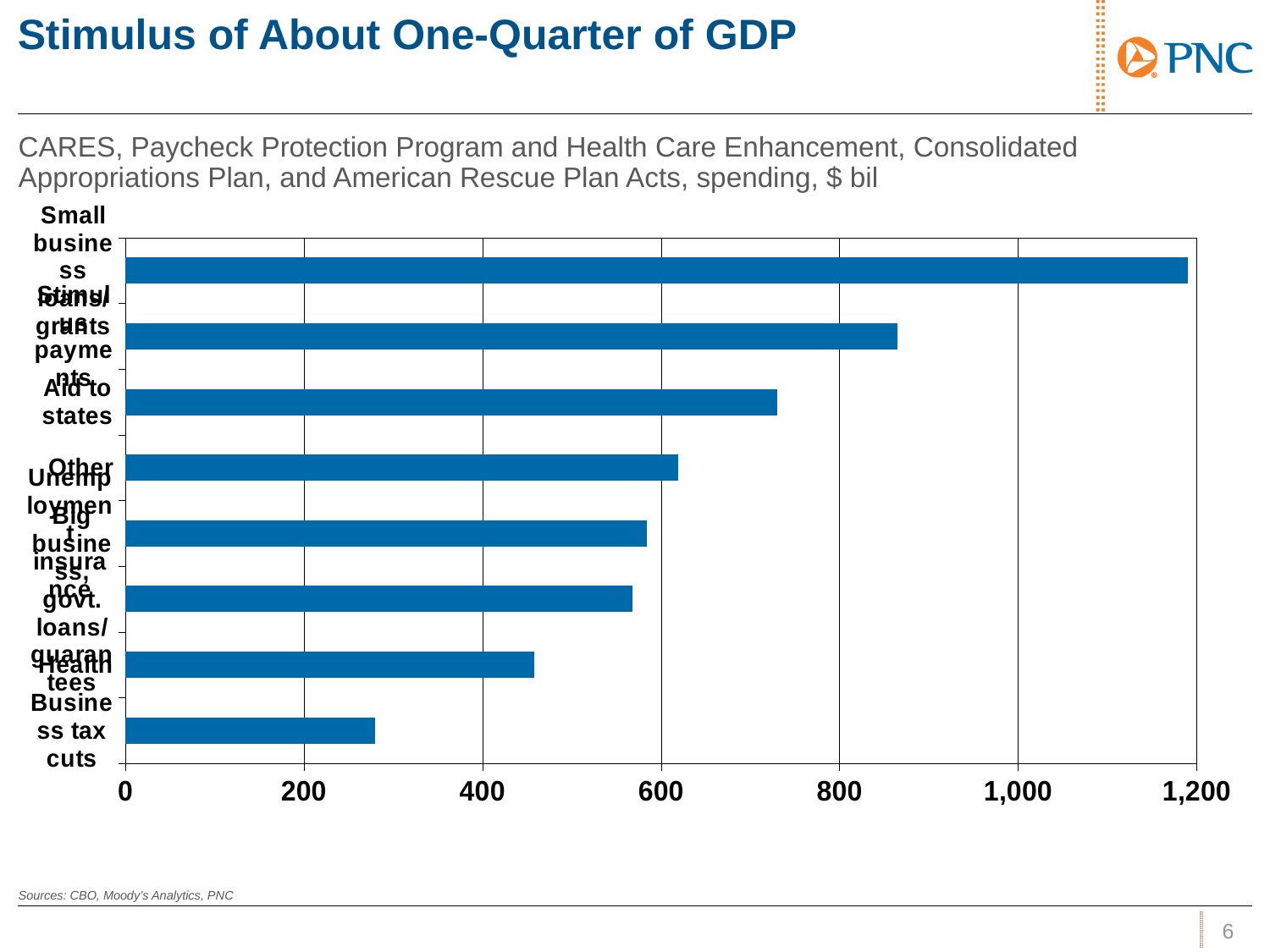
What kind of chart is shown on the slide? bar chart How many bars (categories) does the chart show? 8 Is the value for Health greater or less than 600? less Which is larger, the value for Aid to states or the value for Other? Aid to states Do the bar values rise or fall going from the top bar to the bottom bar? fall Is the value for Aid to states greater or less than 600? greater In what units is spending shown in the chart? $ bil Which category has the lowest spending in the chart? Business tax cuts Is the value for Business tax cuts greater or less than 400? less Which category has the highest spending in the chart? Small business loans/grants